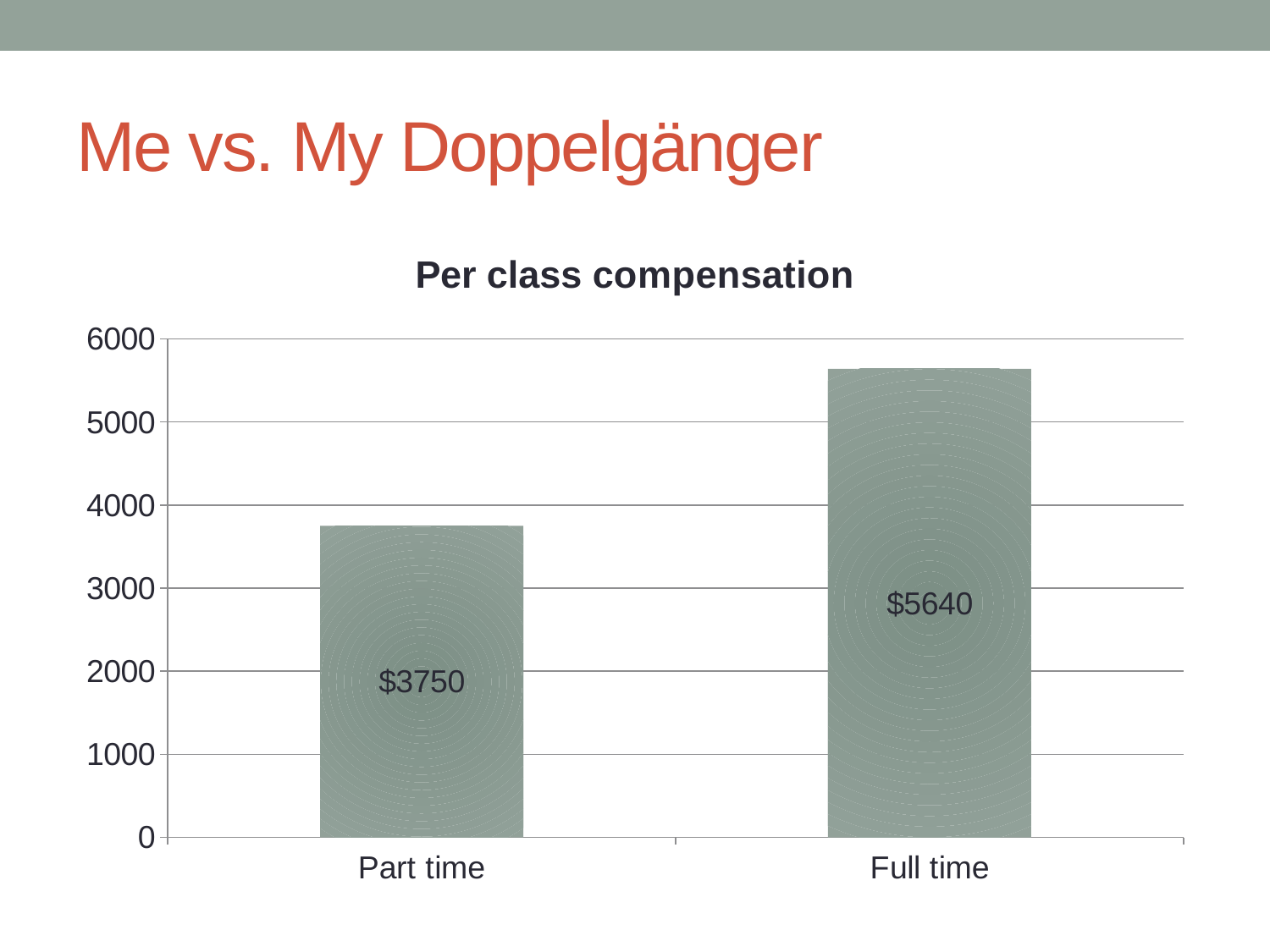
What kind of chart is shown on the slide? bar chart How many categories are shown in the chart? 2 Which is larger, the Part time or the Full time per class compensation? Full time Is the value for Part time greater or less than 4000? less Which category has the lowest per class compensation? Part time Is the value for Full time greater or less than 5000? greater What is the per class compensation for Part time? $3750 What is the title of the chart? Per class compensation Which category has the highest per class compensation? Full time What is the difference between the Full time and Part time per class compensation? $1890 What is the per class compensation for Full time? $5640 What is the highest value shown on the vertical axis? 6000